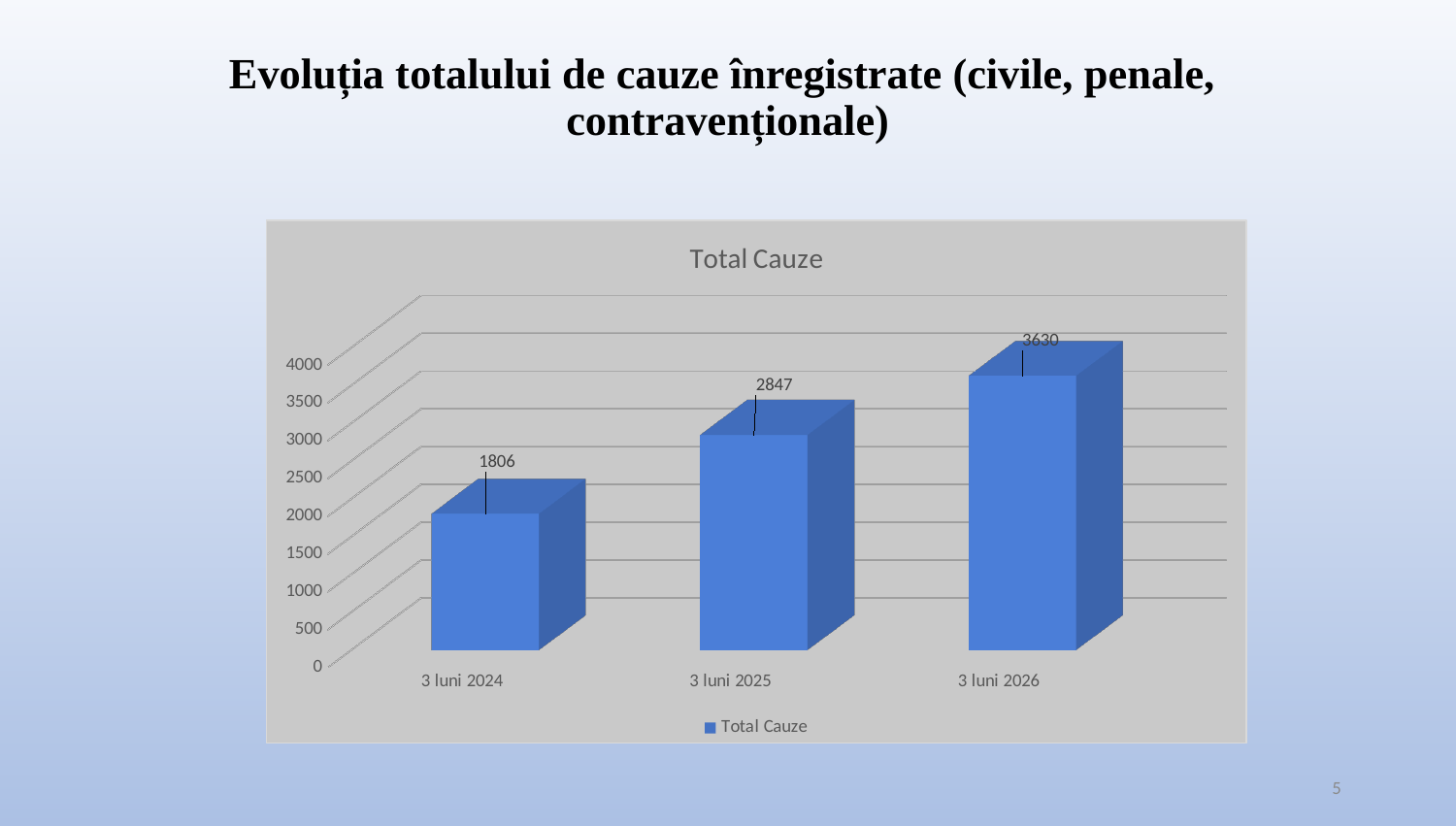
What is the value for 3 luni 2024? 1806 What kind of chart is shown? bar chart What is the value for 3 luni 2026? 3630 How many categories are shown on the x axis? 3 Do the values rise or fall from 3 luni 2024 to 3 luni 2026? rise How many series does the legend list? 1 What is the difference between the values for 3 luni 2026 and 3 luni 2024? 1824 Which category has the highest value? 3 luni 2026 Which is larger, the value for 3 luni 2025 or the value for 3 luni 2024? 3 luni 2025 What is the difference between the values for 3 luni 2025 and 3 luni 2024? 1041 What is the value for 3 luni 2025? 2847 Which category has the lowest value? 3 luni 2024